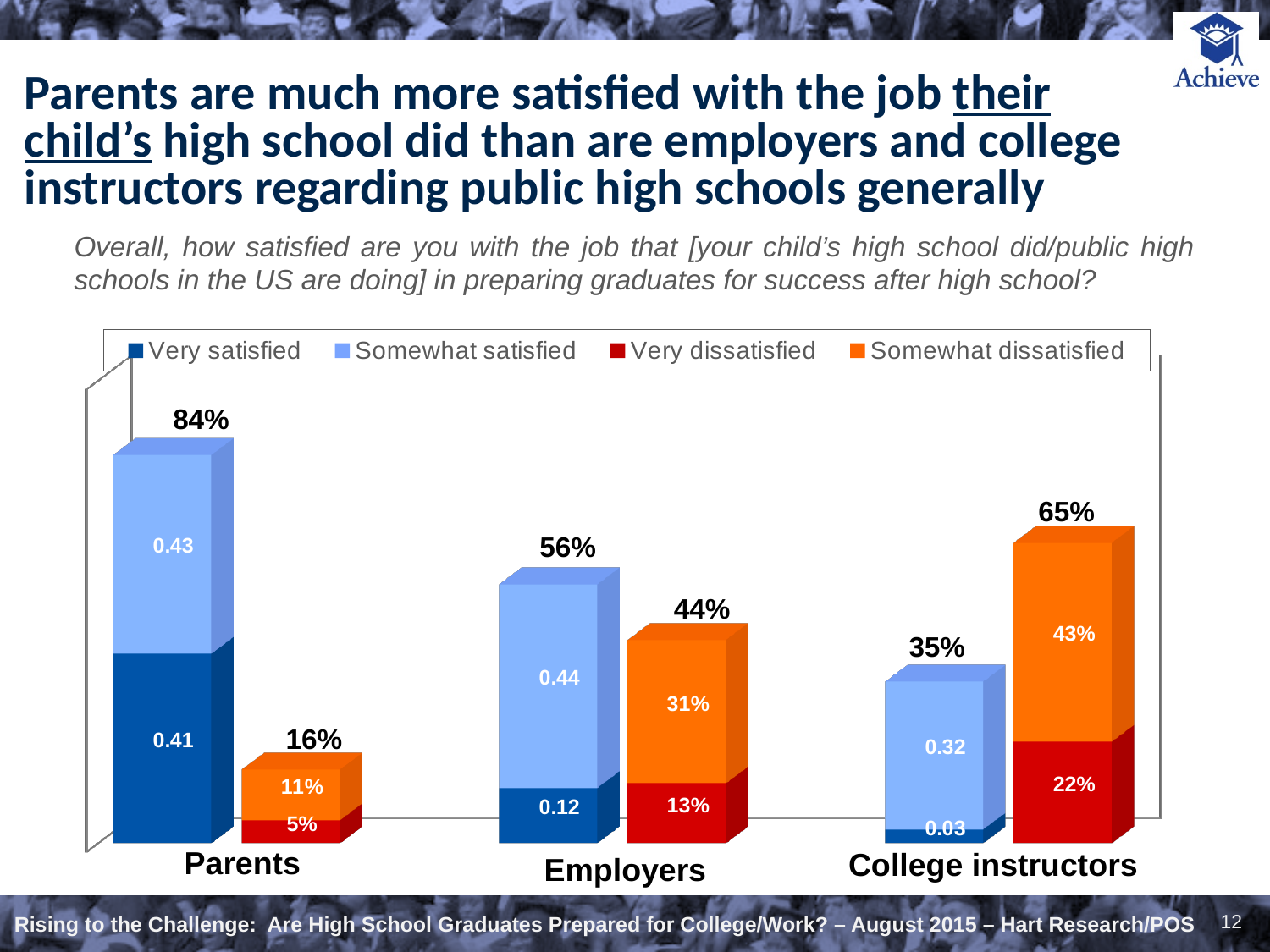
What is the Very dissatisfied value for Parents? 5% Which group has the highest total satisfied bar? Parents What is the total of the satisfied stacked bar for Employers? 56% What is the Somewhat dissatisfied value for College instructors? 43% Which is larger for Employers: the Somewhat dissatisfied value or the Very dissatisfied value? Somewhat dissatisfied What is the Somewhat satisfied value for Parents? 0.43 How many series does the legend list? 4 What is the Very satisfied value for Employers? 0.12 What is the total of the dissatisfied stacked bar for College instructors? 65% What is the difference between the total satisfied bar for Parents (84%) and for College instructors (35%)? 49% What kind of chart is shown on the slide? Stacked bar chart Which group has the lowest Very satisfied value? College instructors